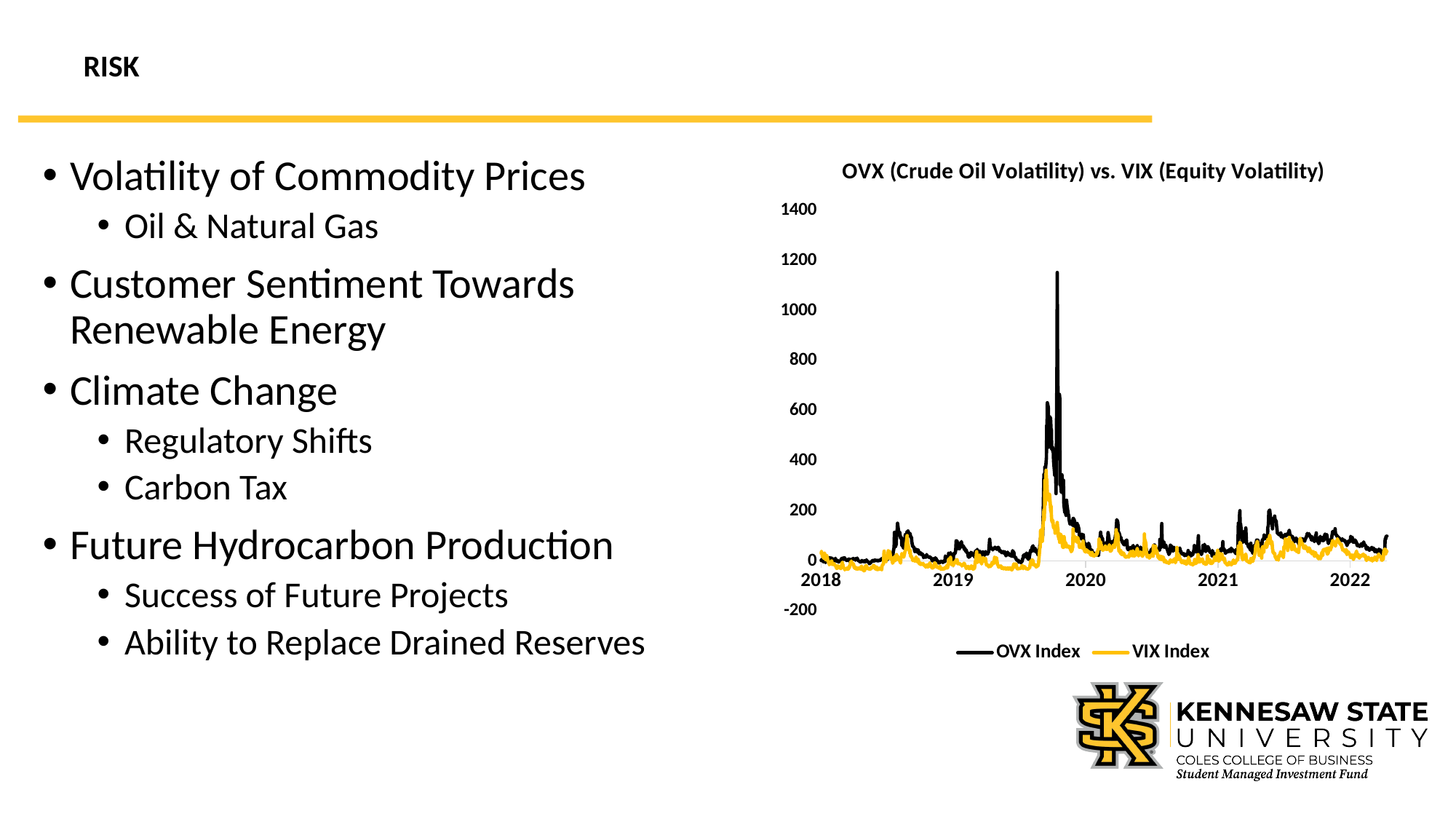
What is the highest value shown on the y axis of the chart? 1400 Between which two year labels on the x axis does the largest spike in the OVX Index occur? 2019 and 2020 What kind of chart is shown on the slide? line chart Which series reaches the higher peak value in the chart, OVX Index or VIX Index? OVX Index What is the title of the chart? OVX (Crude Oil Volatility) vs. VIX (Equity Volatility) Is the highest peak of the VIX Index greater or less than 200? greater Is the highest peak of the VIX Index greater or less than 600? less How many series does the legend of the chart list? 2 Which colour is used for the VIX Index line in the chart? yellow Is the highest peak of the OVX Index greater or less than 1000? greater How many year labels are shown on the x axis of the chart? 5